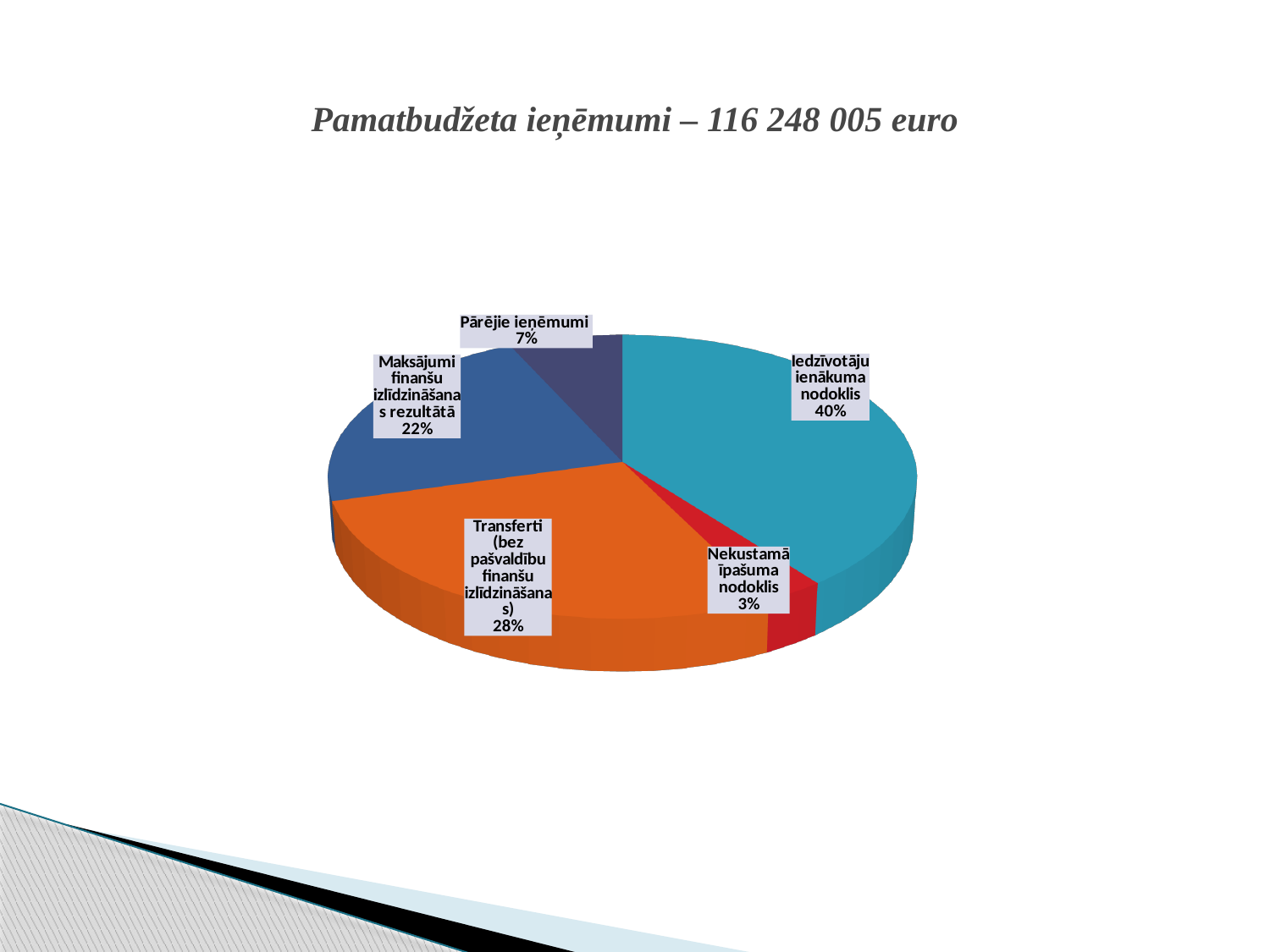
Which category has the largest share of the pie? Iedzīvotāju ienākuma nodoklis What share of the pie does Nekustamā īpašuma nodoklis represent? 3% How many categories are shown in the pie chart? 5 What is the difference in percentage points between Iedzīvotāju ienākuma nodoklis and Transferti (bez pašvaldību finanšu izlīdzināšanas)? 12 percentage points What share of the pie does Pārējie ieņēmumi represent? 7% Which category has the smallest share of the pie? Nekustamā īpašuma nodoklis What kind of chart is shown on the slide? Pie chart What is the title of the slide above the chart? Pamatbudžeta ieņēmumi – 116 248 005 euro What share of the pie does Iedzīvotāju ienākuma nodoklis represent? 40% Which is larger: the share for Maksājumi finanšu izlīdzināšanas rezultātā or the share for Pārējie ieņēmumi? Maksājumi finanšu izlīdzināšanas rezultātā